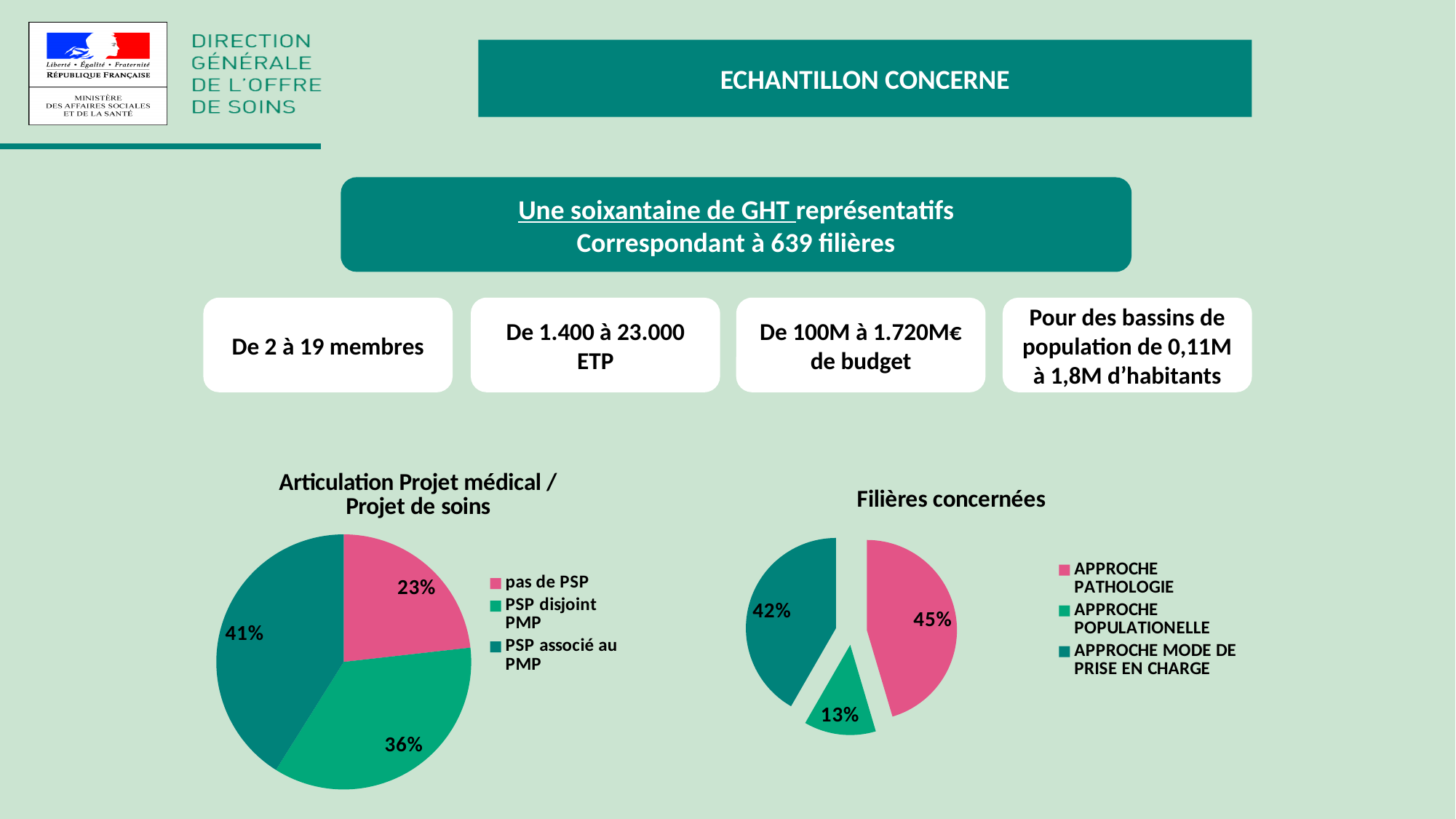
In the 'Filières concernées' chart, what is the difference in percentage points between 'APPROCHE MODE DE PRISE EN CHARGE' and 'APPROCHE POPULATIONELLE'? 29 In the 'Articulation Projet médical / Projet de soins' chart, what is the difference in percentage points between 'PSP associé au PMP' and 'PSP disjoint PMP'? 5 In the 'Articulation Projet médical / Projet de soins' chart, what share is labelled for 'PSP associé au PMP'? 41% In the 'Filières concernées' chart, what share is labelled for 'APPROCHE POPULATIONELLE'? 13% In the 'Articulation Projet médical / Projet de soins' chart, which category has the smallest slice? pas de PSP In the 'Articulation Projet médical / Projet de soins' chart, what share is labelled for 'pas de PSP'? 23% In the 'Filières concernées' chart, which is larger: 'APPROCHE PATHOLOGIE' or 'APPROCHE MODE DE PRISE EN CHARGE'? APPROCHE PATHOLOGIE In the 'Filières concernées' chart, which category has the smallest slice? APPROCHE POPULATIONELLE In the 'Filières concernées' chart, what share is labelled for 'APPROCHE PATHOLOGIE'? 45% In the 'Articulation Projet médical / Projet de soins' chart, which category has the largest slice? PSP associé au PMP In the 'Articulation Projet médical / Projet de soins' chart, how many categories does the legend list? 3 What type of chart is 'Filières concernées'? Pie chart